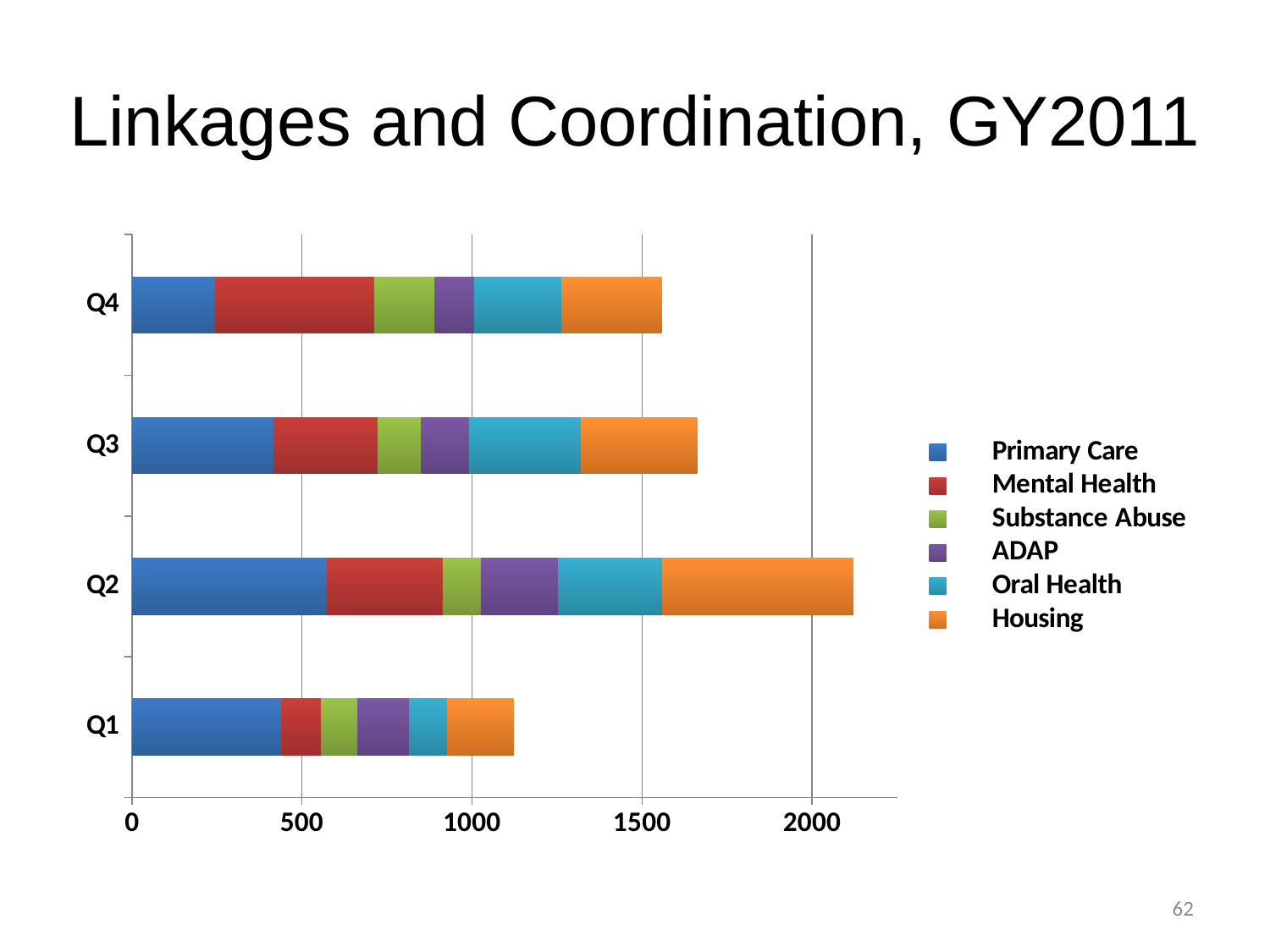
What kind of chart is shown on the slide? Stacked bar chart Which quarter has the shortest total bar? Q1 Is the total bar length for Q4 greater or less than 1500? greater What is the title of the slide containing the chart? Linkages and Coordination, GY2011 Is the total bar length for Q1 greater or less than 1000? greater Is the Primary Care segment for Q2 greater or less than 500? greater Which quarter has the longest total bar? Q2 Which has the larger total bar, Q3 or Q1? Q3 How many quarters (categories) are plotted on the chart? 4 How many series does the legend list? 6